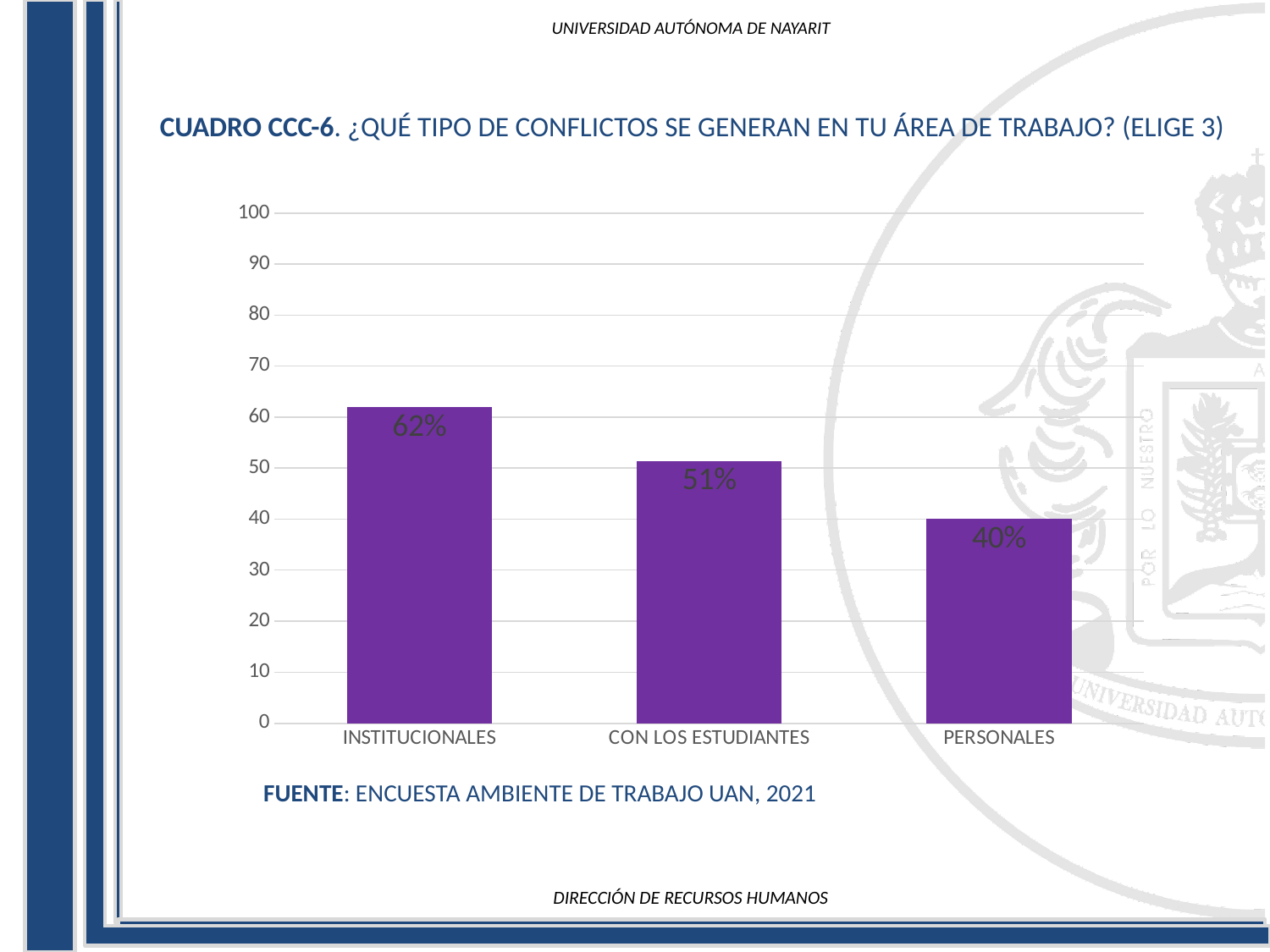
Which is larger, the value for CON LOS ESTUDIANTES or the value for PERSONALES? CON LOS ESTUDIANTES Which category has the lowest value? PERSONALES What is the value for CON LOS ESTUDIANTES? 51% What is the value for PERSONALES? 40% Is the value for INSTITUCIONALES greater or less than 50? greater What is the difference between the values for CON LOS ESTUDIANTES and PERSONALES? 11% Which category has the highest value? INSTITUCIONALES What kind of chart is shown on the slide? bar chart How many categories are shown in the chart? 3 Do the values rise or fall from left to right along the x axis? fall What is the value for INSTITUCIONALES? 62% What is the difference between the values for INSTITUCIONALES and PERSONALES? 22%